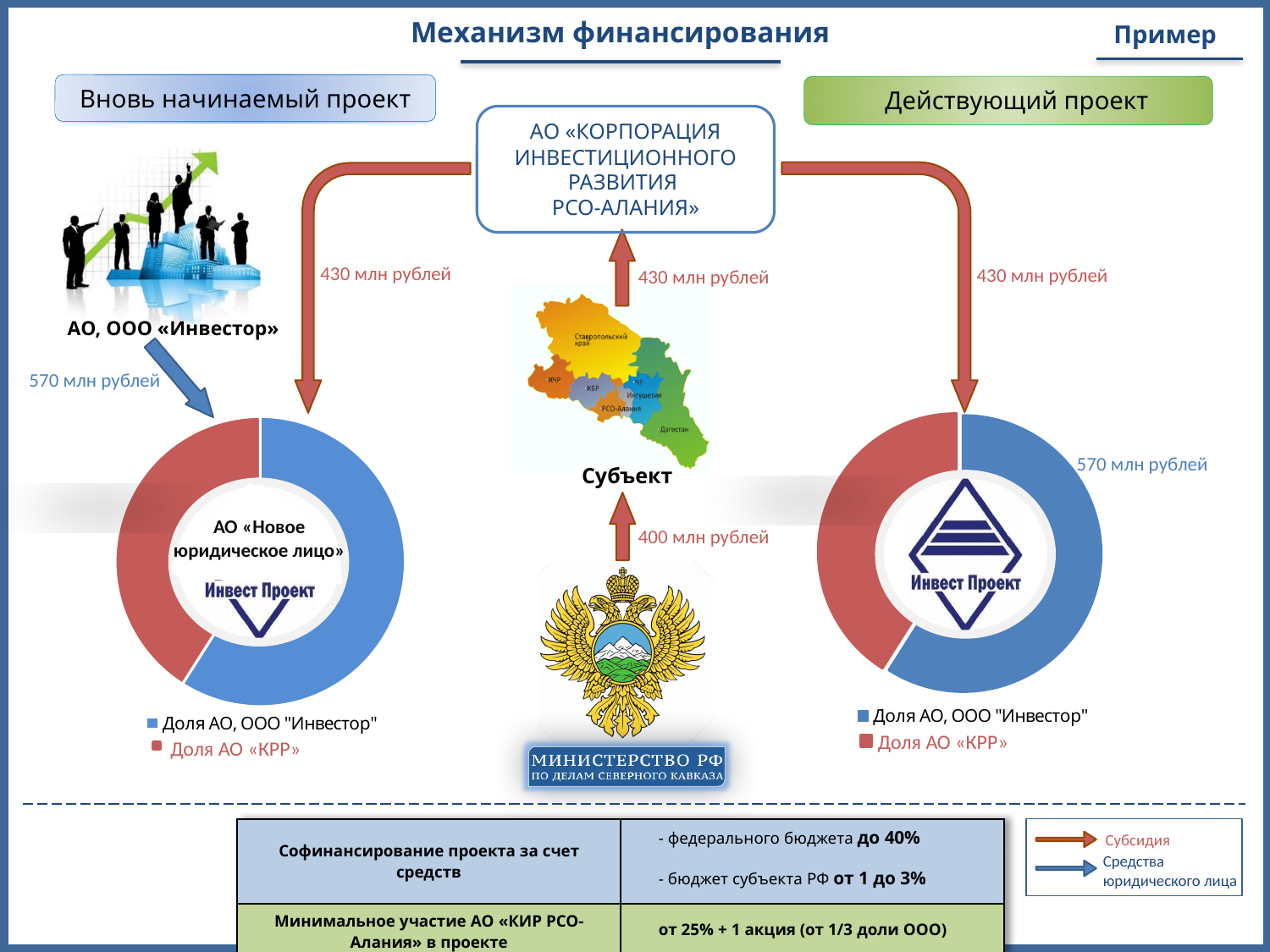
In the right chart ("Действующий проект"), which slice is the smallest? Доля АО «КРР» How many slices does the right chart ("Действующий проект") have? 2 What kind of chart is shown under the heading "Вновь начинаемый проект" on the left of the slide? doughnut chart What kind of chart is shown under the heading "Действующий проект" on the right of the slide? doughnut chart In the left chart ("Вновь начинаемый проект"), which slice is larger: "Доля АО, ООО "Инвестор"" or "Доля АО «КРР»"? Доля АО, ООО "Инвестор" What amount is labelled on the red arrow feeding the "Доля АО «КРР»" slice of the left chart ("Вновь начинаемый проект")? 430 млн рублей What amount is labelled next to the blue "Доля АО, ООО "Инвестор"" slice of the right chart ("Действующий проект")? 570 млн рублей What is the difference between the 570 млн рублей investor share and the 430 млн рублей КРР share shown for the right chart ("Действующий проект")? 140 млн рублей In the right chart ("Действующий проект"), which slice is the largest? Доля АО, ООО "Инвестор" How many entries does the legend of the left chart ("Вновь начинаемый проект") list? 2 What text is written in the centre of the left chart ("Вновь начинаемый проект")? АО «Новое юридическое лицо» What colour represents "Доля АО «КРР»" in the legend of the left chart? red